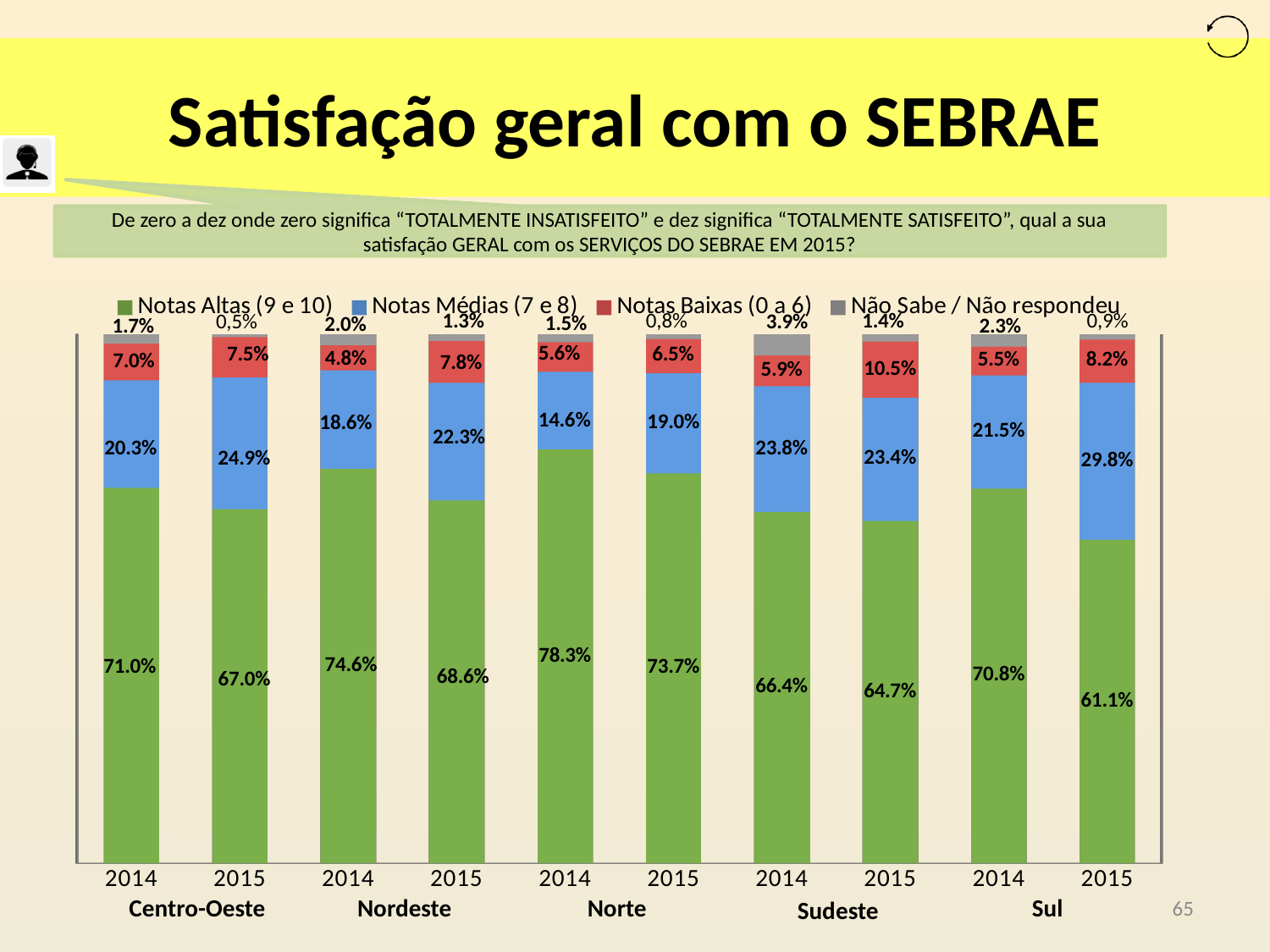
What is the value of Não Sabe / Não respondeu for Sudeste in 2014? 3.9% What is the difference between the Notas Altas (9 e 10) values for Sul in 2014 and 2015? 9.7% Which is larger, the Notas Médias (7 e 8) value for Centro-Oeste 2015 or for Nordeste 2015? Centro-Oeste 2015 Which bar has the highest value for Notas Altas (9 e 10)? Norte 2014 Which bar has the lowest value for Notas Altas (9 e 10)? Sul 2015 What is the value of Notas Médias (7 e 8) for Sul in 2015? 29.8% What is the value of Notas Baixas (0 a 6) for Sudeste in 2015? 10.5% Does the Notas Altas (9 e 10) value rise or fall from 2014 to 2015 in every region? Fall How many series does the legend list? 4 How many bars are plotted in the chart? 10 What is the value of Notas Altas (9 e 10) for Norte in 2014? 78.3% What type of chart is shown on the slide? Stacked bar chart